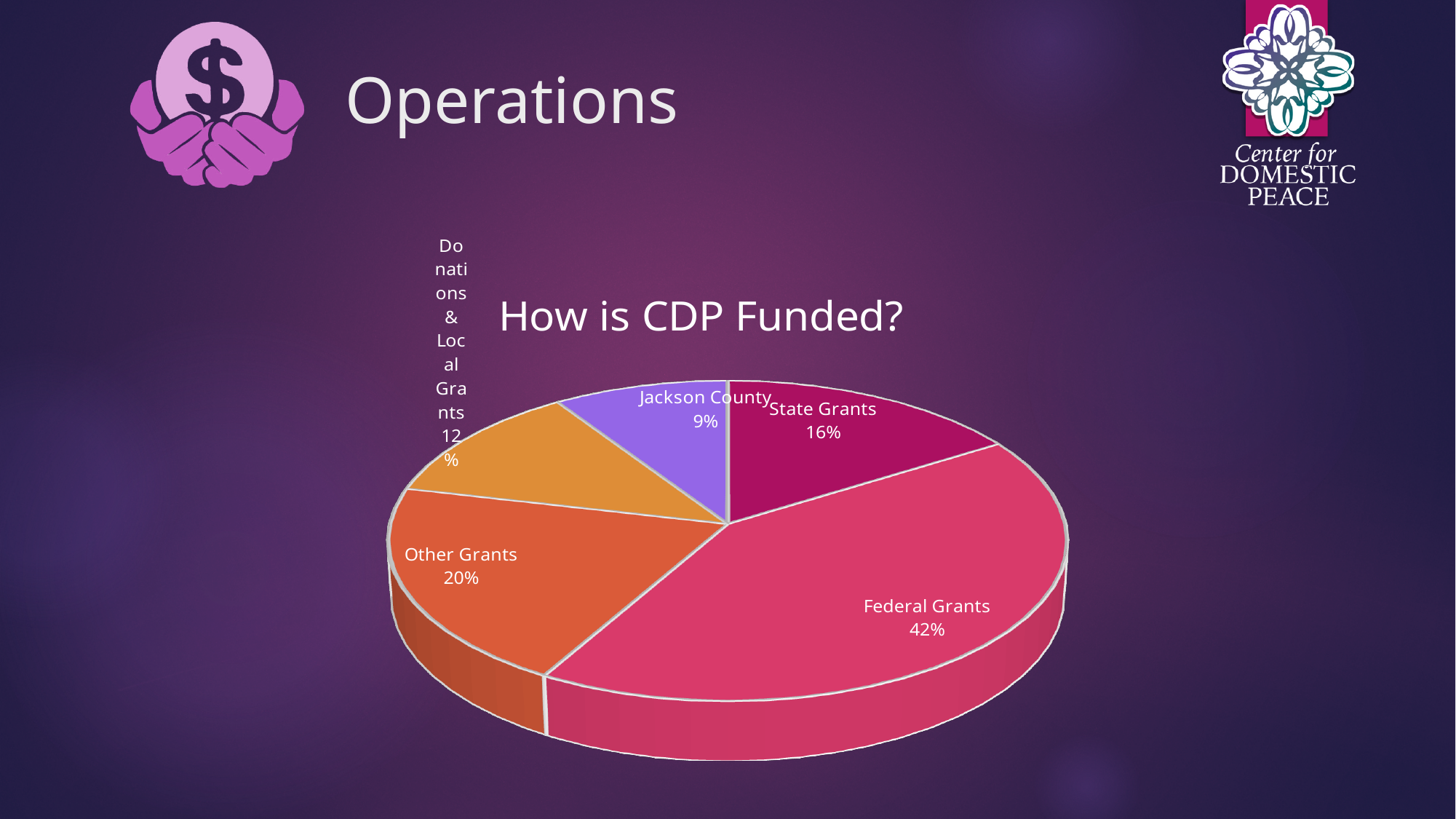
Which funding source has the largest share of the pie? Federal Grants What share of CDP funding comes from Donations & Local Grants? 12% What share of CDP funding comes from State Grants? 16% What share of CDP funding comes from Federal Grants? 42% What share of CDP funding comes from Other Grants? 20% How many slices does the pie chart have? 5 Which funding source has the smallest share of the pie? Jackson County What is the title of the chart? How is CDP Funded? Which is larger, the share for State Grants or the share for Donations & Local Grants? State Grants What kind of chart is shown on the slide? pie chart What is the difference in percentage points between Federal Grants and Other Grants? 22 What share of CDP funding comes from Jackson County? 9%